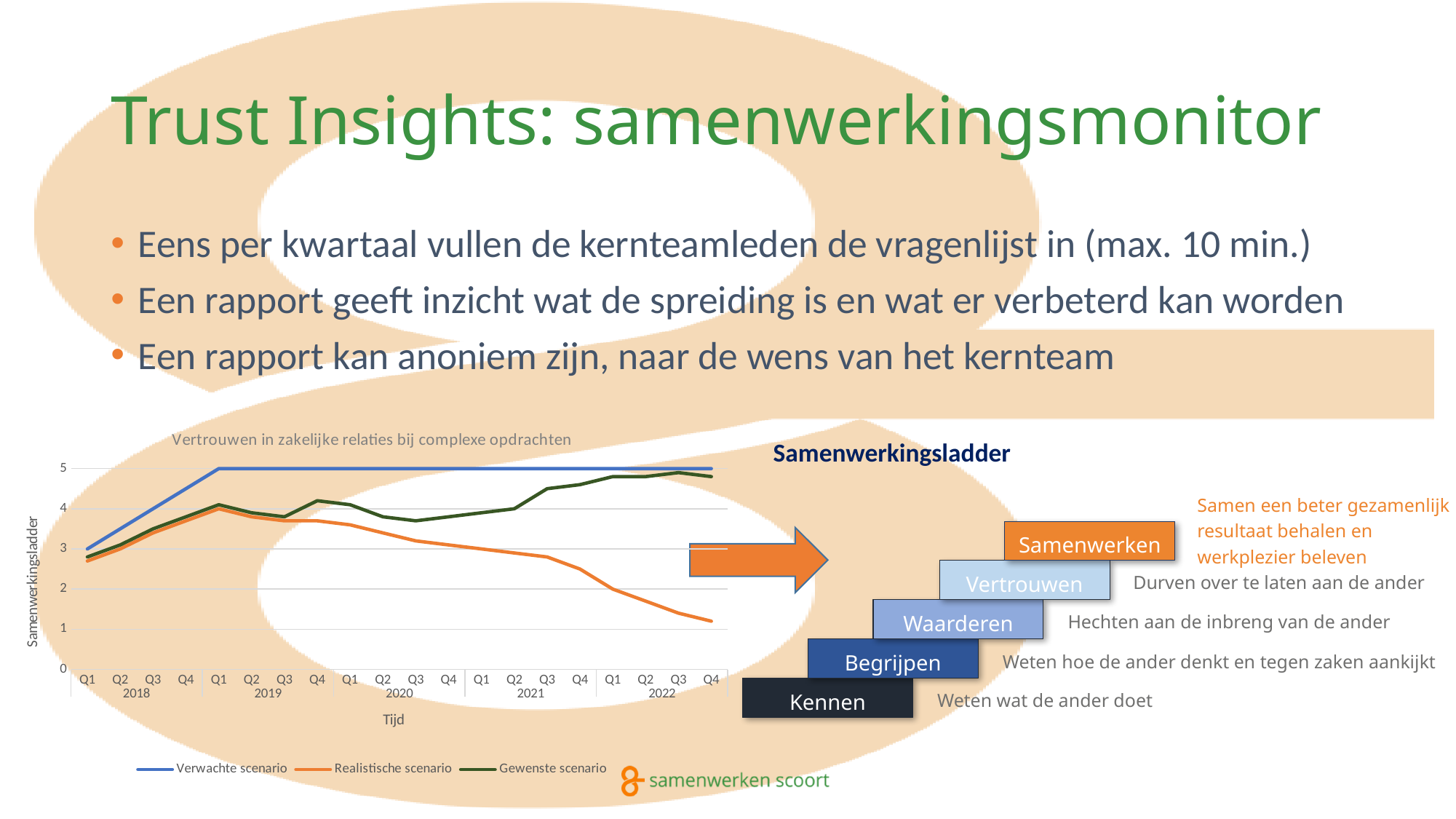
Is the value of the Realistische scenario at Q4 2022 greater or less than 2? less How many series does the chart legend list? 3 Which series has the highest value at Q4 2022? Verwachte scenario At Q4 2022, which is larger: the Gewenste scenario or the Realistische scenario? Gewenste scenario Is the value of the Realistische scenario at Q1 2018 greater or less than 3? less What is the title of the chart? Vertrouwen in zakelijke relaties bij complexe opdrachten What is the value of the Verwachte scenario at Q1 2019? 5 Is the value of the Gewenste scenario at Q4 2022 greater or less than 4? greater How many quarterly points are plotted along the x axis of the chart? 20 What is the value of the Verwachte scenario at Q4 2022? 5 Does the Realistische scenario rise or fall from Q1 2019 to Q4 2022? fall What kind of chart is shown on the slide? line chart